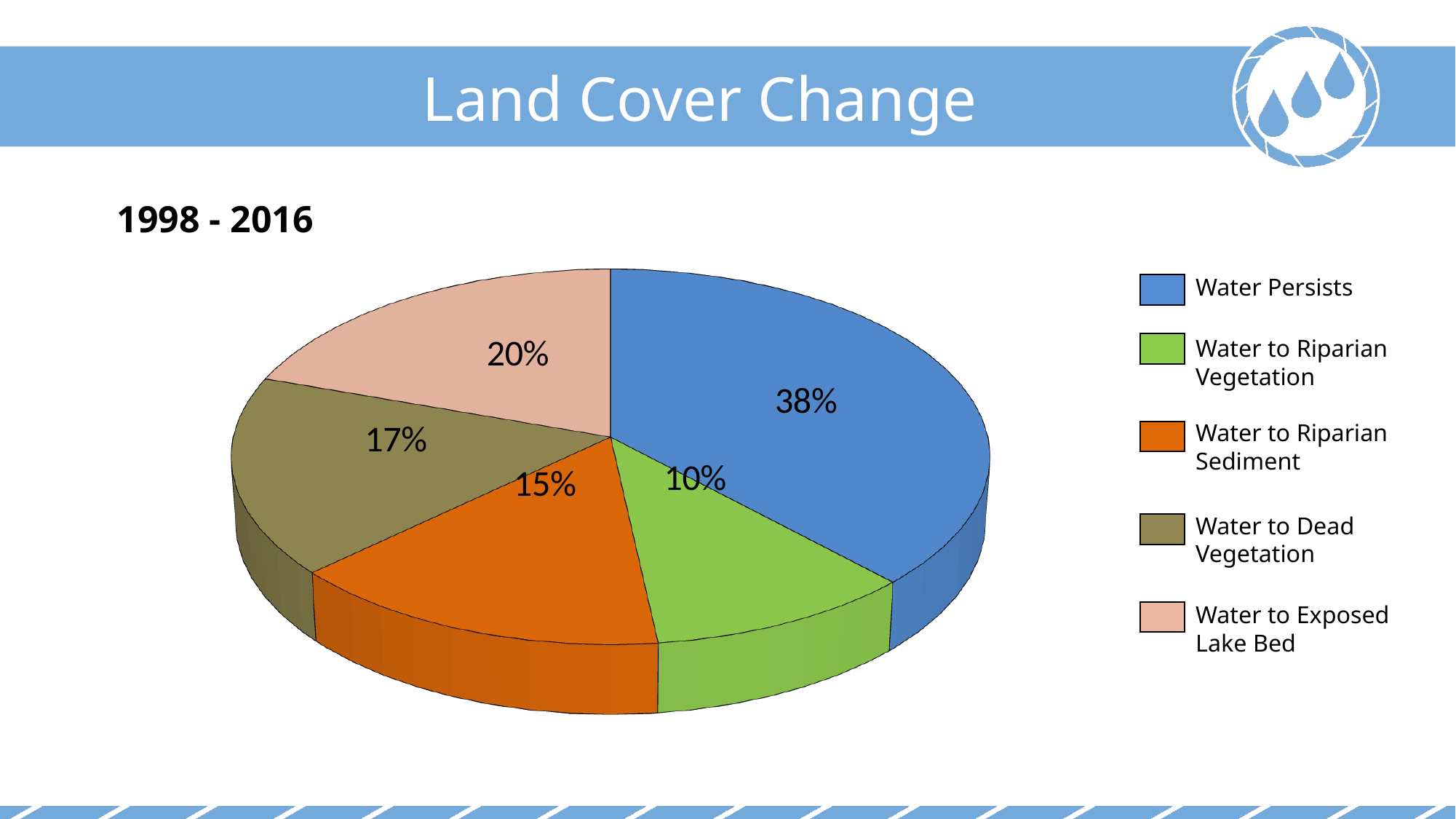
What time period is labelled above the chart? 1998 - 2016 Which category has the smallest slice of the pie? Water to Riparian Vegetation What share of the pie does Water to Exposed Lake Bed represent? 20% What share of the pie does Water to Riparian Vegetation represent? 10% What share of the pie does Water to Dead Vegetation represent? 17% What kind of chart is shown on the slide? Pie chart What is the difference in percentage points between Water Persists and Water to Exposed Lake Bed? 18 How many categories are shown in the pie chart? 5 Which category has the largest slice of the pie? Water Persists Which is larger, the share for Water to Dead Vegetation or the share for Water to Riparian Sediment? Water to Dead Vegetation